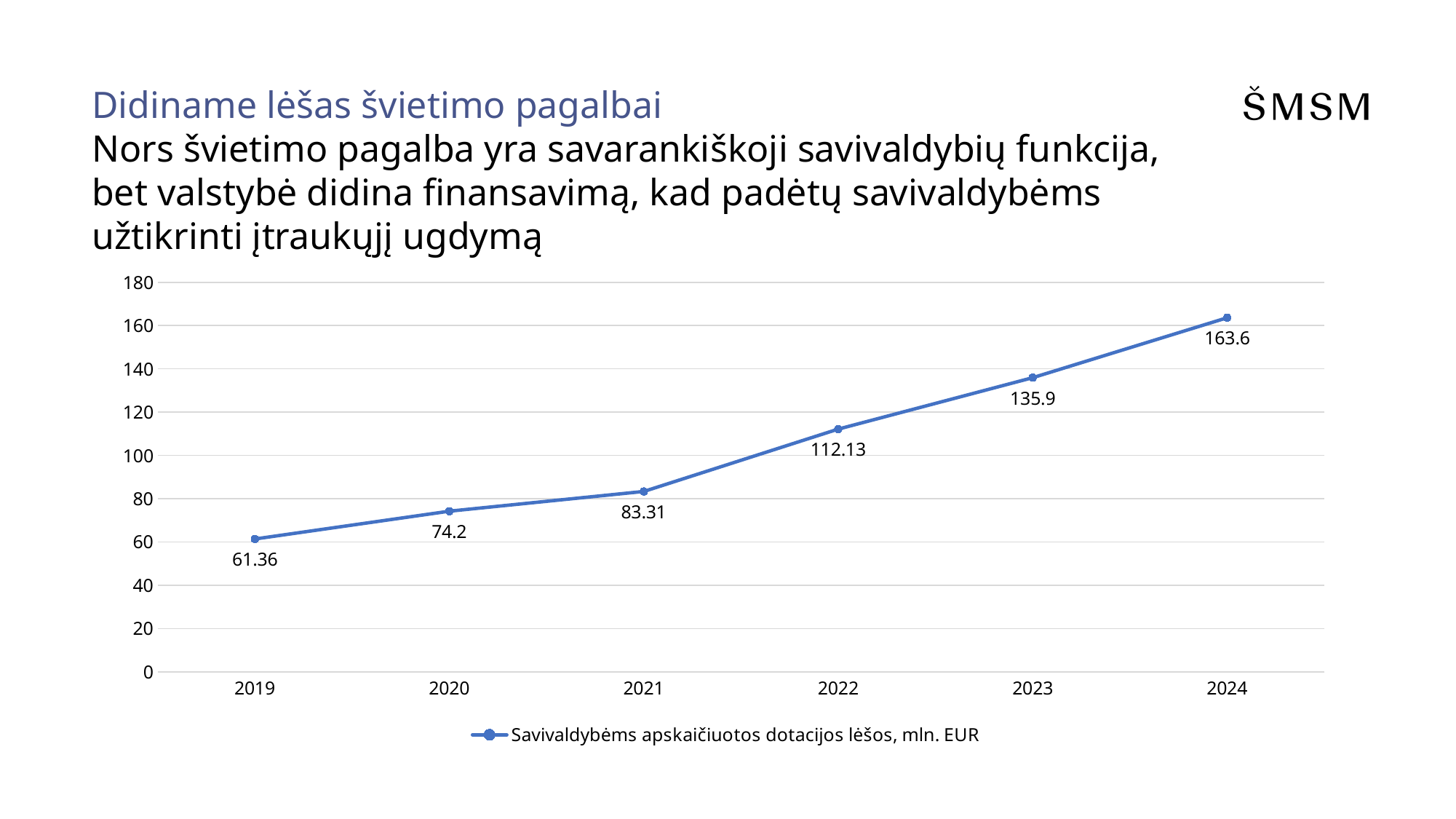
Which year has the highest value? 2024 What is the value for 2024? 163.6 What kind of chart is shown on the slide? line chart Is the value for 2023 greater or less than 120? greater Do the values rise or fall from 2019 to 2024? rise Which is larger, the value for 2021 or the value for 2022? 2022 What is the difference between the values for 2024 and 2023? 27.7 Which year has the lowest value? 2019 What is the value for 2022? 112.13 How many years are plotted on the x axis? 6 What is the value for 2019? 61.36 What is the difference between the values for 2020 and 2019? 12.84